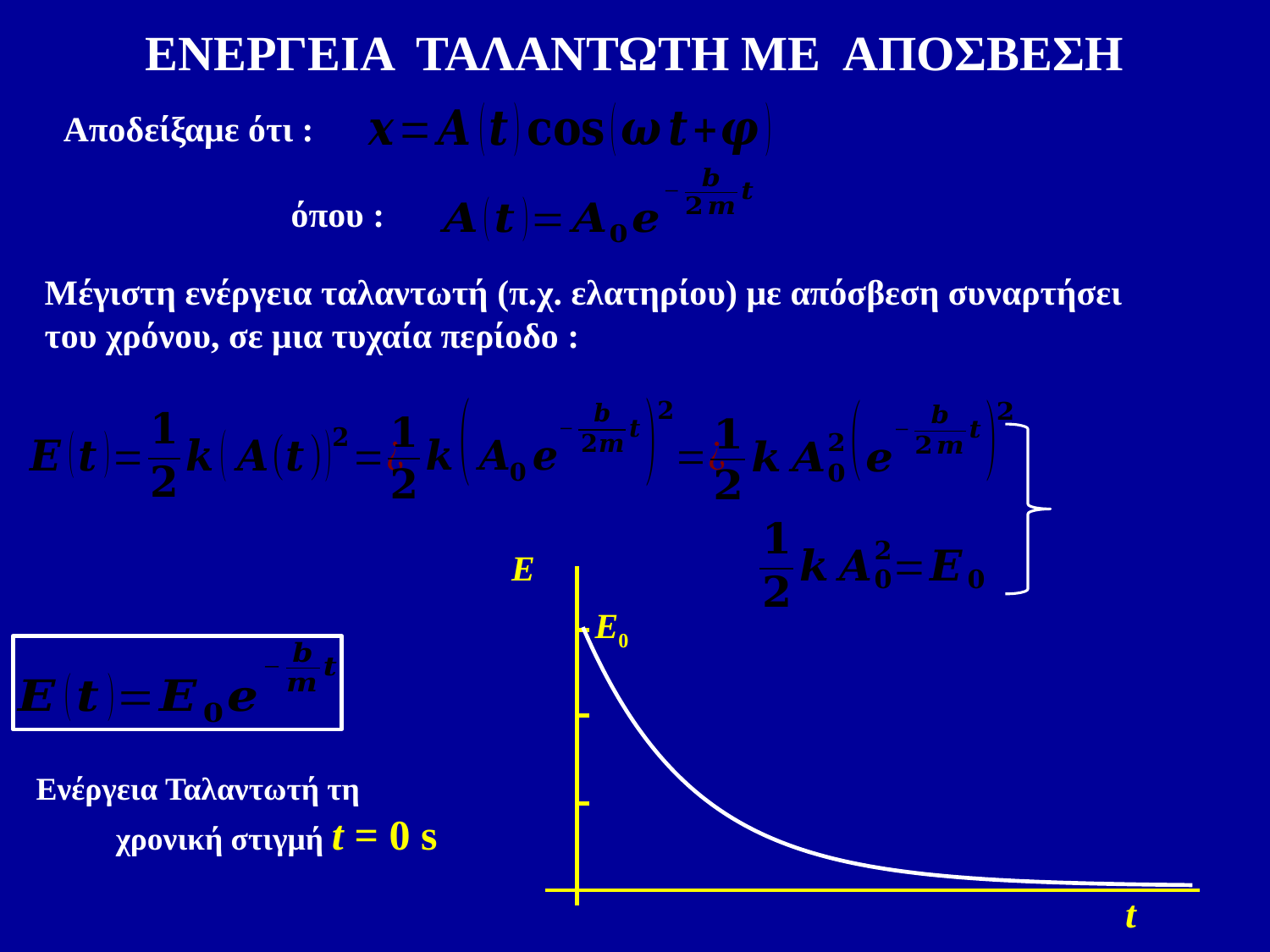
How many curves are plotted on the graph? 1 What kind of chart is shown at the bottom right of the slide? line chart What value is marked on the curve at t = 0? E0 Does the plotted curve rise or fall as t increases? fall What label is written on the vertical axis of the graph? E At which end of the t axis is the curve highest, the left or the right? left What label is written on the horizontal axis of the graph? t Is the value of E at the right end of the graph larger or smaller than E0? smaller